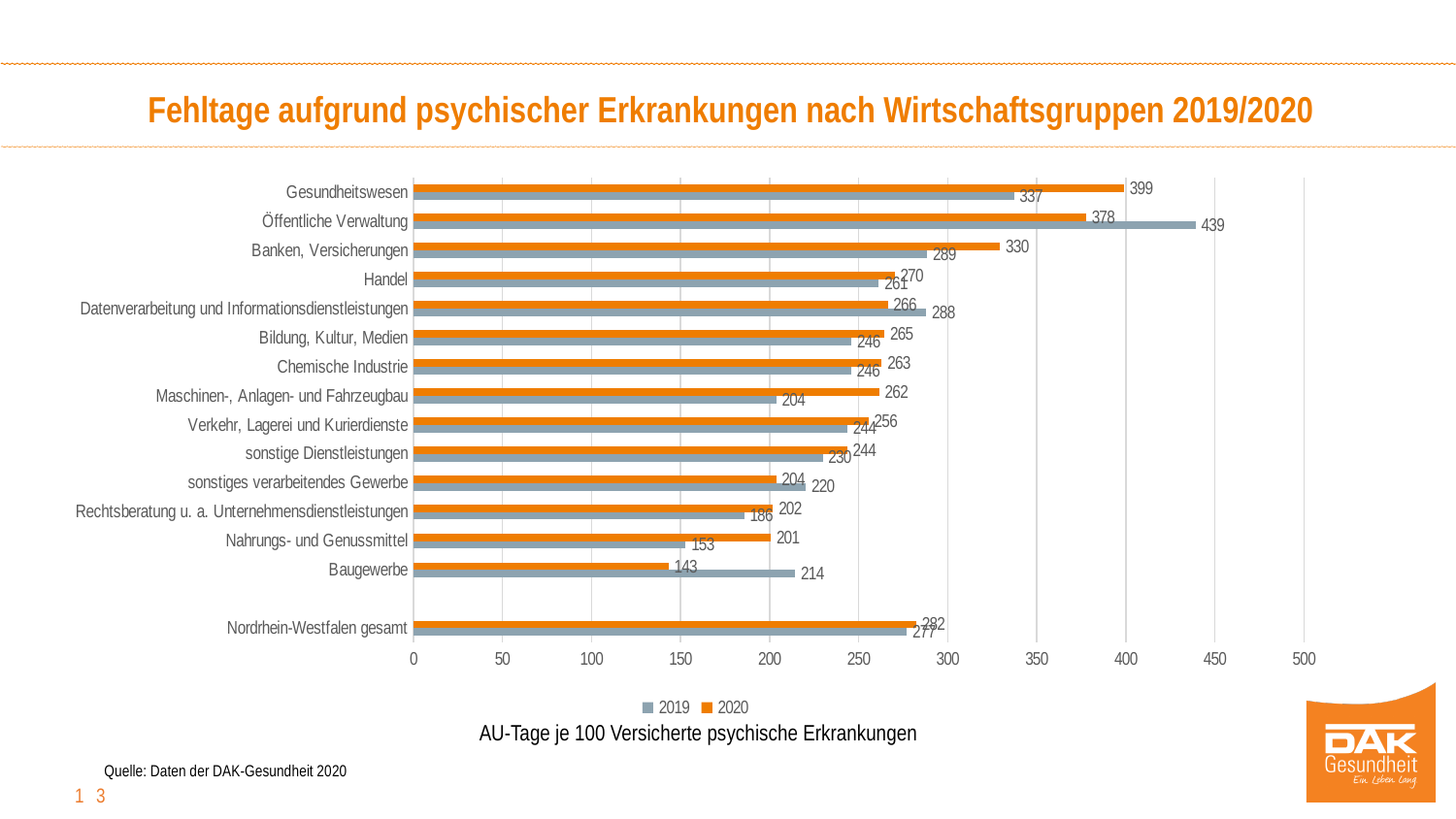
Which category has the highest 2020 value? Gesundheitswesen What is the 2020 value for Gesundheitswesen? 399 What is the 2019 value for Öffentliche Verwaltung? 439 What is the 2020 value for Nordrhein-Westfalen gesamt? 282 For Datenverarbeitung und Informationsdienstleistungen, which year has the larger value, 2019 or 2020? 2019 How many series does the legend list? 2 Which category has the lowest 2020 value? Baugewerbe What is the difference between the 2019 and 2020 values for Baugewerbe? 71 How many categories are shown on the chart? 15 What kind of chart is shown on the slide? Bar chart Which category has the highest 2019 value? Öffentliche Verwaltung What is the 2019 value for Nahrungs- und Genussmittel? 153